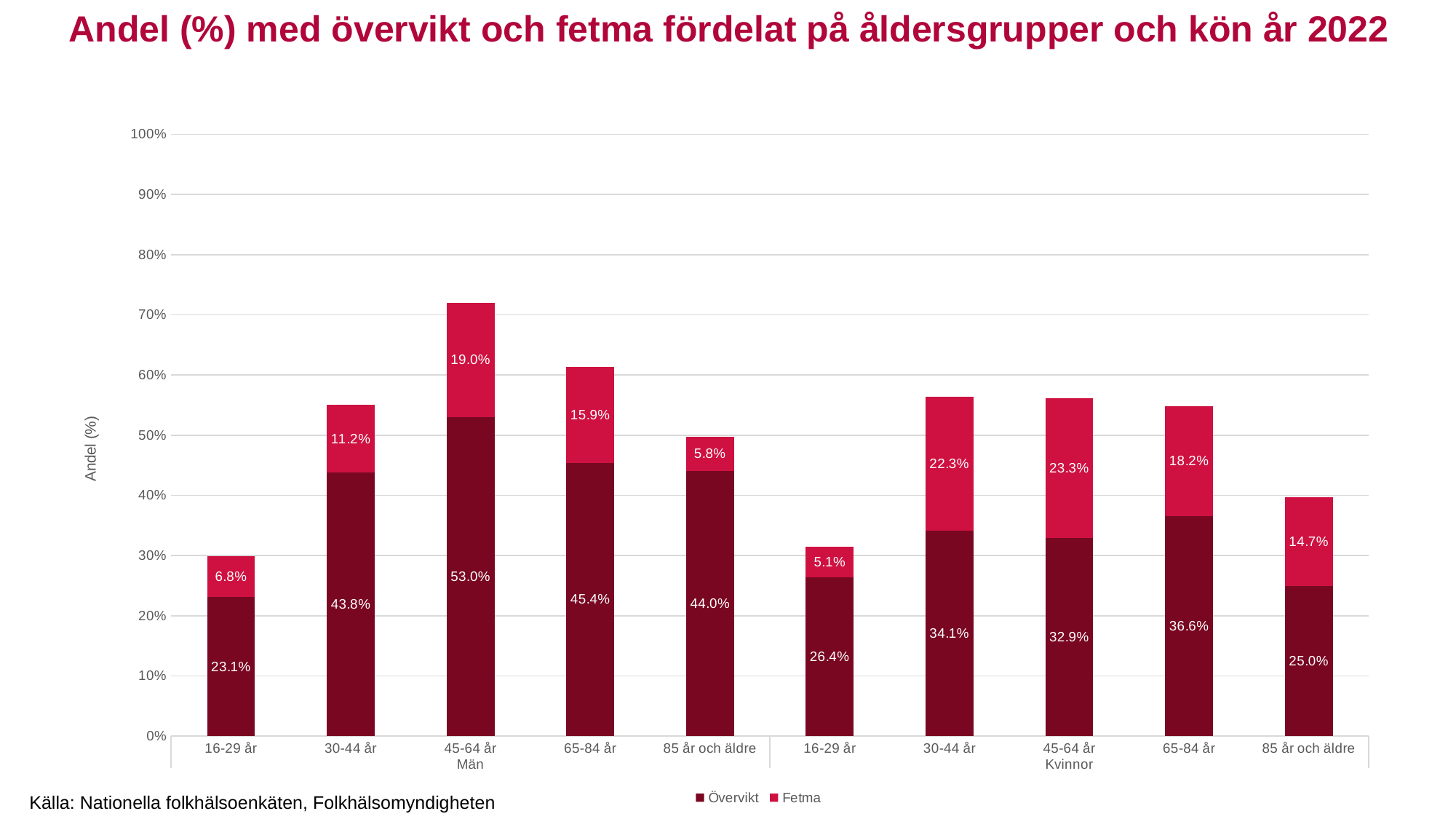
What is the Övervikt value for men (Män) aged 45-64 år? 53.0% What is the Fetma value for women (Kvinnor) aged 30-44 år? 22.3% What is the total (Övervikt plus Fetma) for men (Män) aged 45-64 år? 72.0% Which age group among men (Män) has the highest Övervikt value? 45-64 år What kind of chart is shown on the slide? Stacked bar chart Which is larger: the Övervikt value for men (Män) aged 16-29 år or for women (Kvinnor) aged 16-29 år? Kvinnor 16-29 år How many stacked bars are shown in the chart? 10 What is the difference between the Fetma values for women (Kvinnor) aged 45-64 år and men (Män) aged 45-64 år? 4.3% How many series does the legend list? 2 Is the total stacked bar for women (Kvinnor) aged 85 år och äldre greater or less than 40%? less What is the Fetma value for men (Män) aged 85 år och äldre? 5.8% Which age group among women (Kvinnor) has the lowest Fetma value? 16-29 år